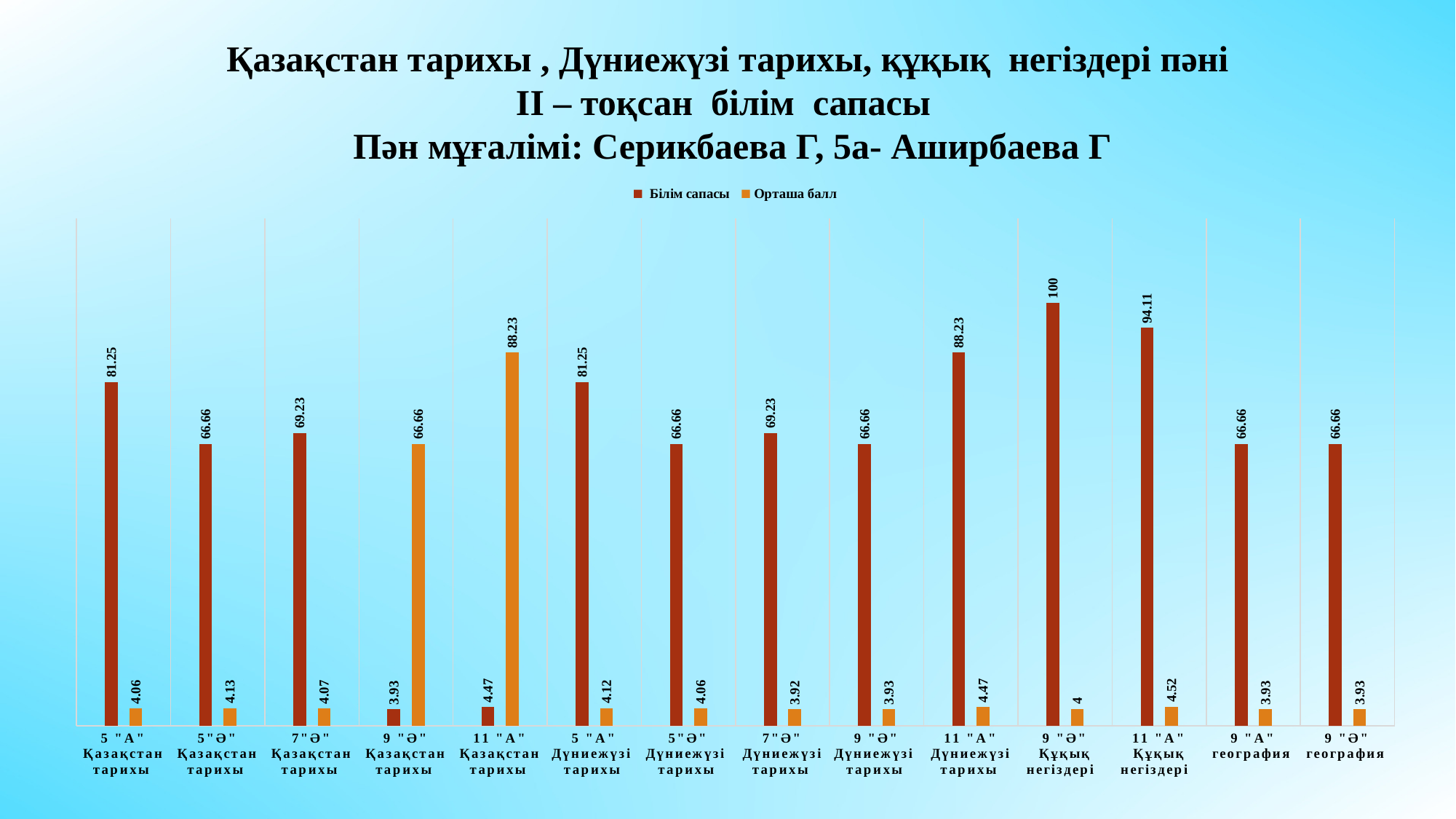
What is the Білім сапасы value for 11 "А" Дүниежүзі тарихы? 88.23 Which has the larger Білім сапасы value: 5 "А" Қазақстан тарихы or 7"Ә" Қазақстан тарихы? 5 "А" Қазақстан тарихы What are the two series named in the legend? Білім сапасы and Орташа балл Which category has the highest Білім сапасы value? 9 "Ә" Құқық негіздері What is the Орташа балл value for 11 "А" Құқық негіздері? 4.52 What is the Білім сапасы value for 9 "Ә" Құқық негіздері? 100 What is the difference between the Білім сапасы values for 9 "Ә" Құқық негіздері and 11 "А" Құқық негіздері? 5.89 What is the Орташа балл value for 7"Ә" Дүниежүзі тарихы? 3.92 What kind of chart is shown on the slide? bar chart How many categories are shown along the x axis? 14 How many series does the legend list? 2 What is the difference between the Білім сапасы values for 5 "А" Дүниежүзі тарихы and 5"Ә" Дүниежүзі тарихы? 14.59